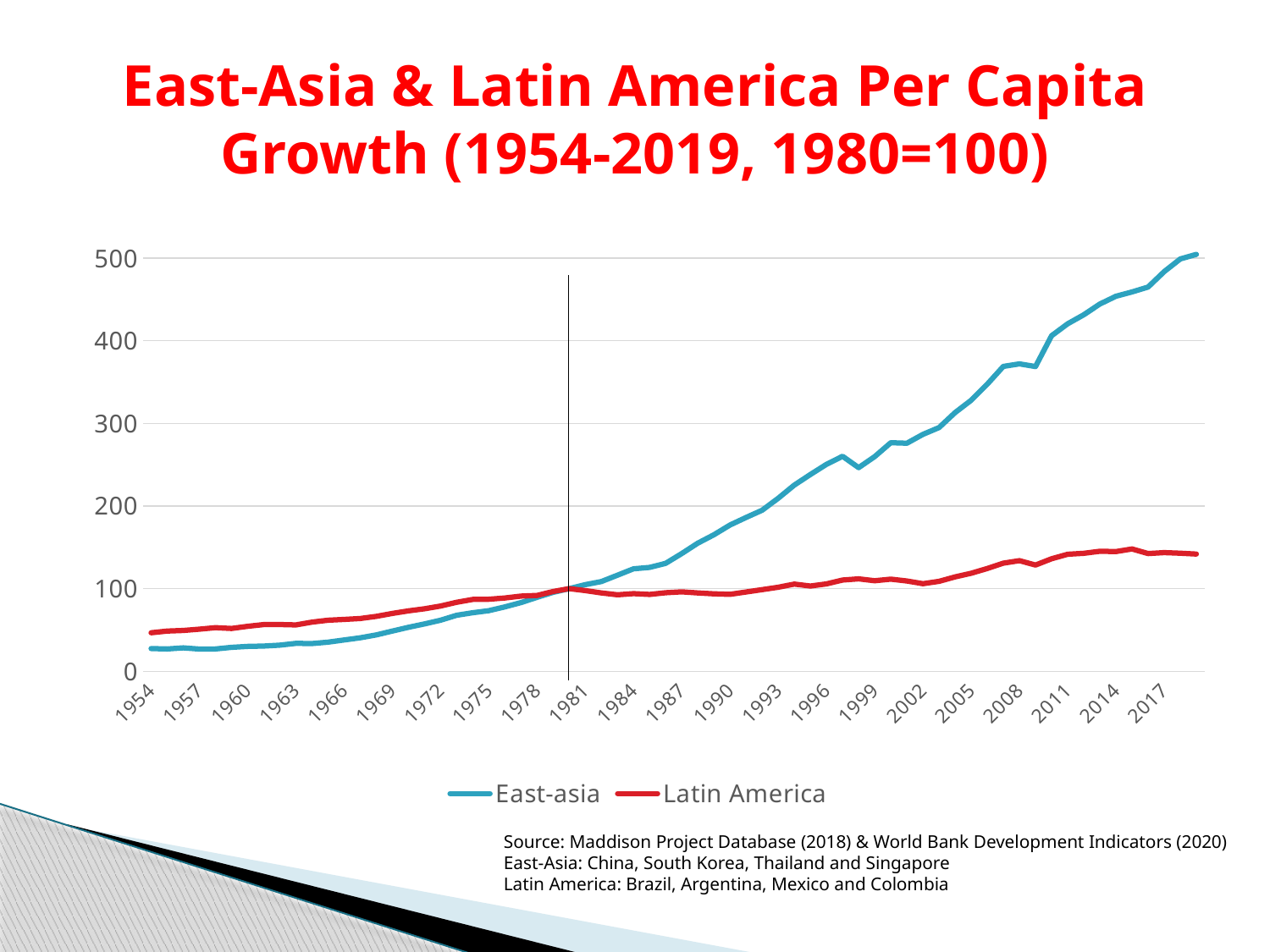
Is the value for East-asia in 1954 greater or less than 100? less Is the value for East-asia in 2017 greater or less than 400? greater Is the value for Latin America in 2017 greater or less than 200? less In 1954, which series has the higher value, East-asia or Latin America? Latin America How many series does the legend list? 2 What is the title of the chart? East-Asia & Latin America Per Capita Growth (1954-2019, 1980=100) Which colour is used for the Latin America line? red In 2017, which series has the higher value, East-asia or Latin America? East-asia Does the East-asia line generally rise or fall from 1954 to 2019? rise What kind of chart is shown on the slide? line chart